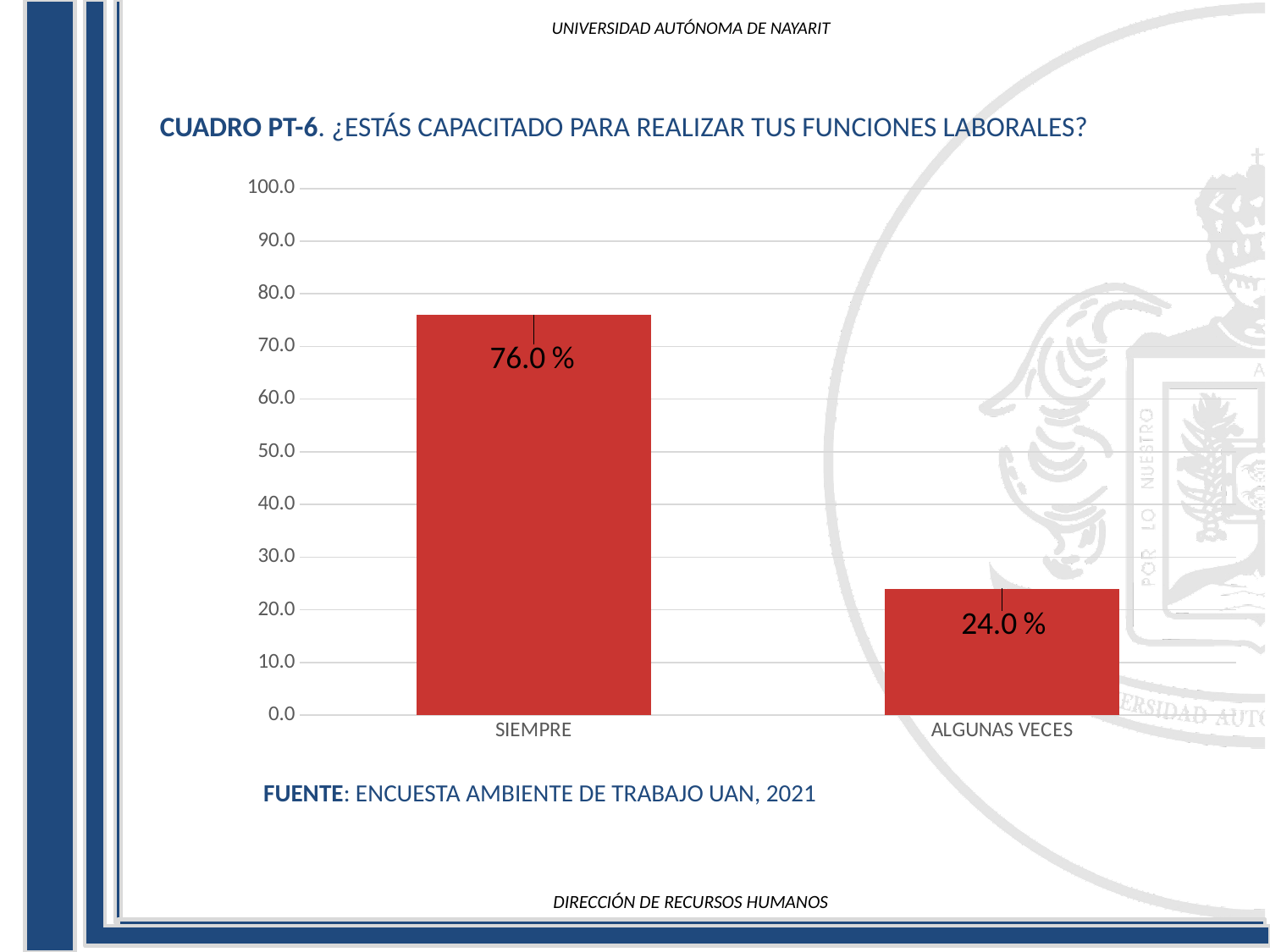
What kind of chart is shown on the slide? bar chart What is the maximum value shown on the y axis? 100.0 What is the value for ALGUNAS VECES? 24.0 % Which is larger, the value for SIEMPRE or the value for ALGUNAS VECES? SIEMPRE Is the value for SIEMPRE greater or less than 70.0? greater What is the value for SIEMPRE? 76.0 % Which category has the highest value? SIEMPRE How many categories are shown on the x axis? 2 Is the value for ALGUNAS VECES greater or less than 30.0? less What is the difference between the values for SIEMPRE and ALGUNAS VECES? 52.0 % What source is cited below the chart? ENCUESTA AMBIENTE DE TRABAJO UAN, 2021 Which category has the lowest value? ALGUNAS VECES